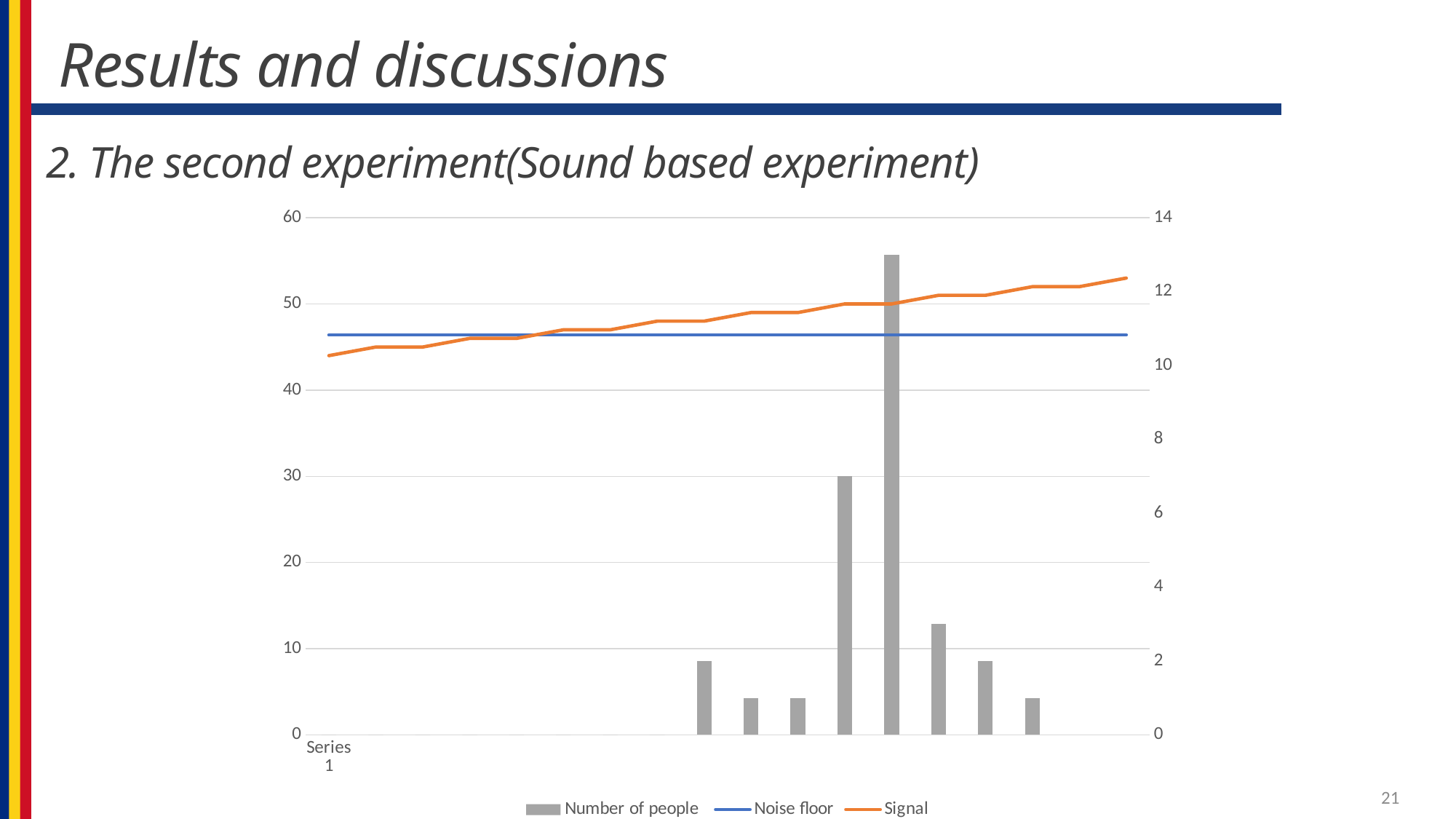
Is the Noise floor value greater or less than 10 on the right axis? greater Which series is drawn as bars? Number of people What colour is the Signal line? Orange What kind of chart is shown on the slide? A combination bar and line chart At the right end of the chart, which is higher: the Signal line or the Noise floor line? Signal How many bars are plotted for Number of people? 8 Does the Signal line rise or fall from left to right? Rises At the left end of the chart, which is higher: the Signal line or the Noise floor line? Noise floor How many series does the legend list? 3